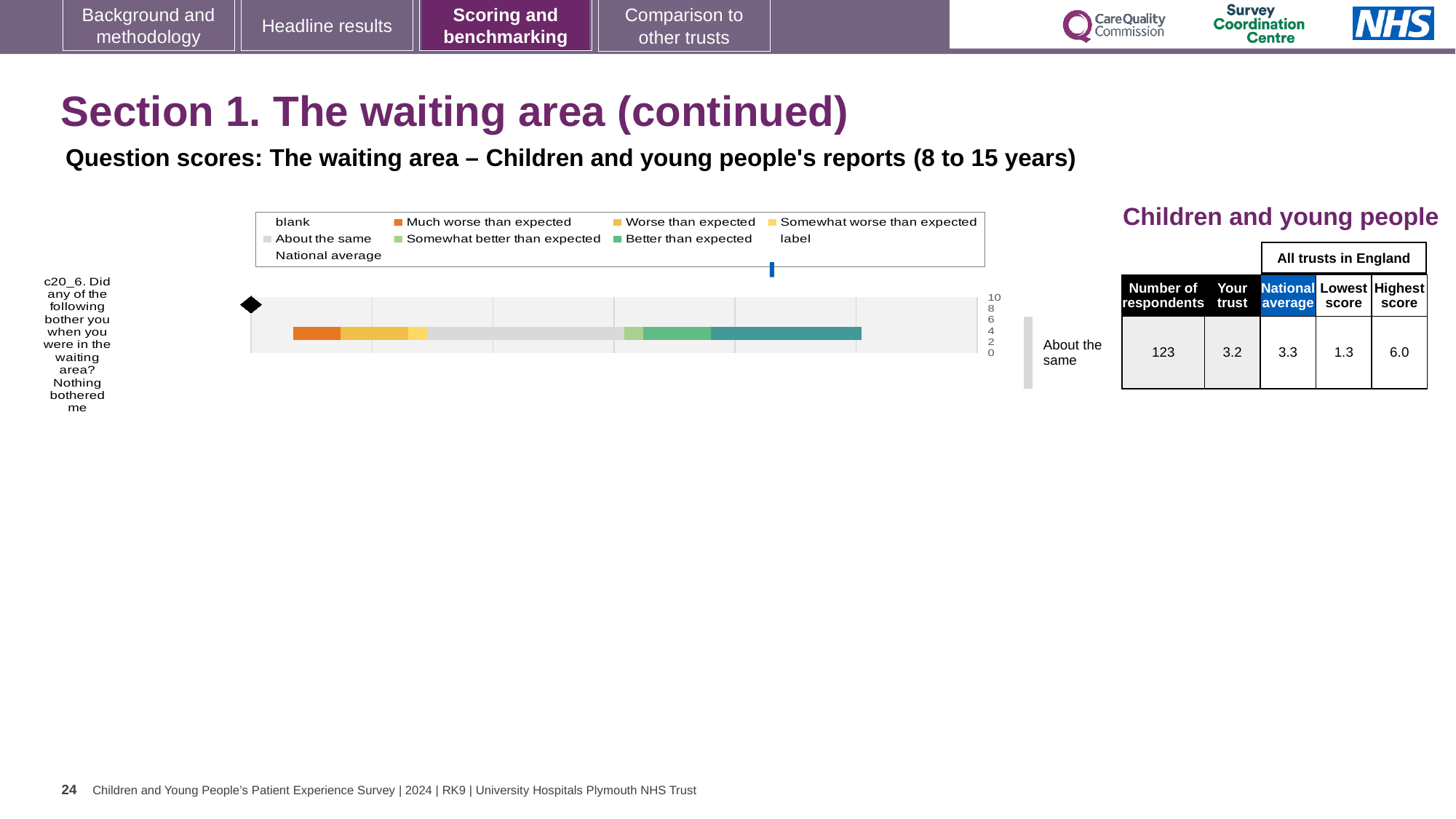
What colour is the 'Much worse than expected' band in the chart? Orange What is the 'Your trust' score shown for question c20_6? 3.2 How many respondents are shown for question c20_6? 123 What is the lowest score across all trusts in England for question c20_6? 1.3 Which is larger for question c20_6, the 'Your trust' score or the national average? National average Which question is plotted in the chart? c20_6. Did any of the following bother you when you were in the waiting area? Nothing bothered me What is the difference between the highest score and the lowest score for question c20_6? 4.7 How many questions (categories) are plotted in the chart? 1 What is the highest score across all trusts in England for question c20_6? 6.0 What kind of chart is shown on the slide? Bar chart What is the national average score shown for question c20_6? 3.3 How many entries does the chart legend list? 9